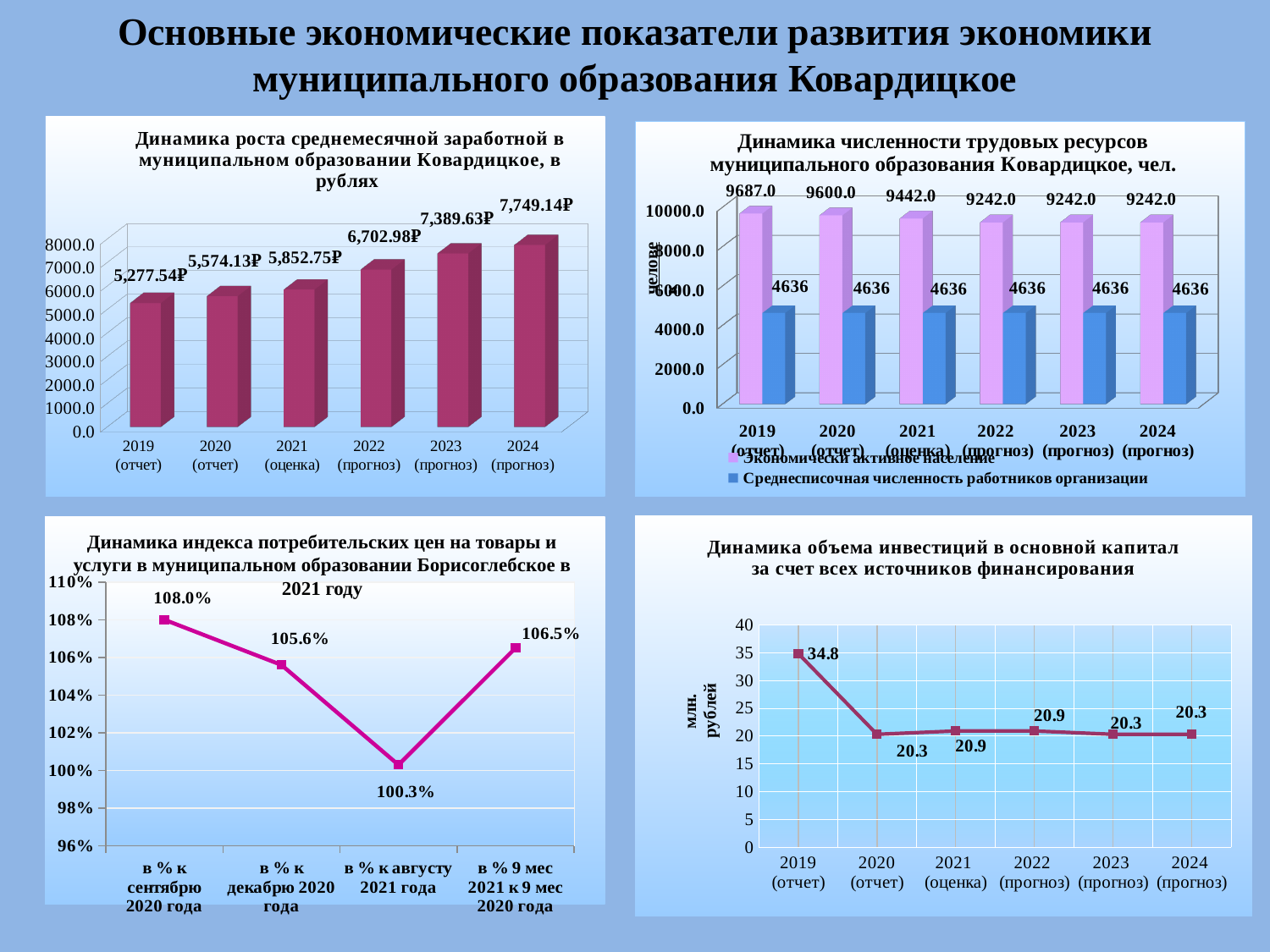
On the chart 'Динамика численности трудовых ресурсов муниципального образования Ковардицкое, чел.', what is the difference between 'Экономически активное население' and 'Среднесписочная численность работников организации' in 2021 (оценка)? 4806 On the chart 'Динамика численности трудовых ресурсов муниципального образования Ковардицкое, чел.', what kind of chart is it? bar chart On the chart 'Динамика объема инвестиций в основной капитал за счет всех источников финансирования', what is the value for 2019 (отчет)? 34.8 On the chart 'Динамика роста среднемесячной заработной в муниципальном образовании Ковардицкое, в рублях', do the values rise or fall from 2019 to 2024? rise On the chart 'Динамика индекса потребительских цен на товары и услуги в муниципальном образовании Борисоглебское в 2021 году', what is the value for 'в % к августу 2021 года'? 100.3% On the chart 'Динамика численности трудовых ресурсов муниципального образования Ковардицкое, чел.', how many series does the legend list? 2 On the chart 'Динамика объема инвестиций в основной капитал за счет всех источников финансирования', what is the difference between the values for 2019 (отчет) and 2020 (отчет)? 14.5 On the chart 'Динамика численности трудовых ресурсов муниципального образования Ковардицкое, чел.', what is the value of 'Экономически активное население' for 2019 (отчет)? 9687.0 On the chart 'Динамика роста среднемесячной заработной в муниципальном образовании Ковардицкое, в рублях', which year has the highest value? 2024 (прогноз) On the chart 'Динамика индекса потребительских цен на товары и услуги в муниципальном образовании Борисоглебское в 2021 году', which category has the highest value? в % к сентябрю 2020 года On the chart 'Динамика роста среднемесячной заработной в муниципальном образовании Ковардицкое, в рублях', what is the value for 2022 (прогноз)? 6,702.98₽ On the chart 'Динамика роста среднемесячной заработной в муниципальном образовании Ковардицкое, в рублях', how many years are shown? 6